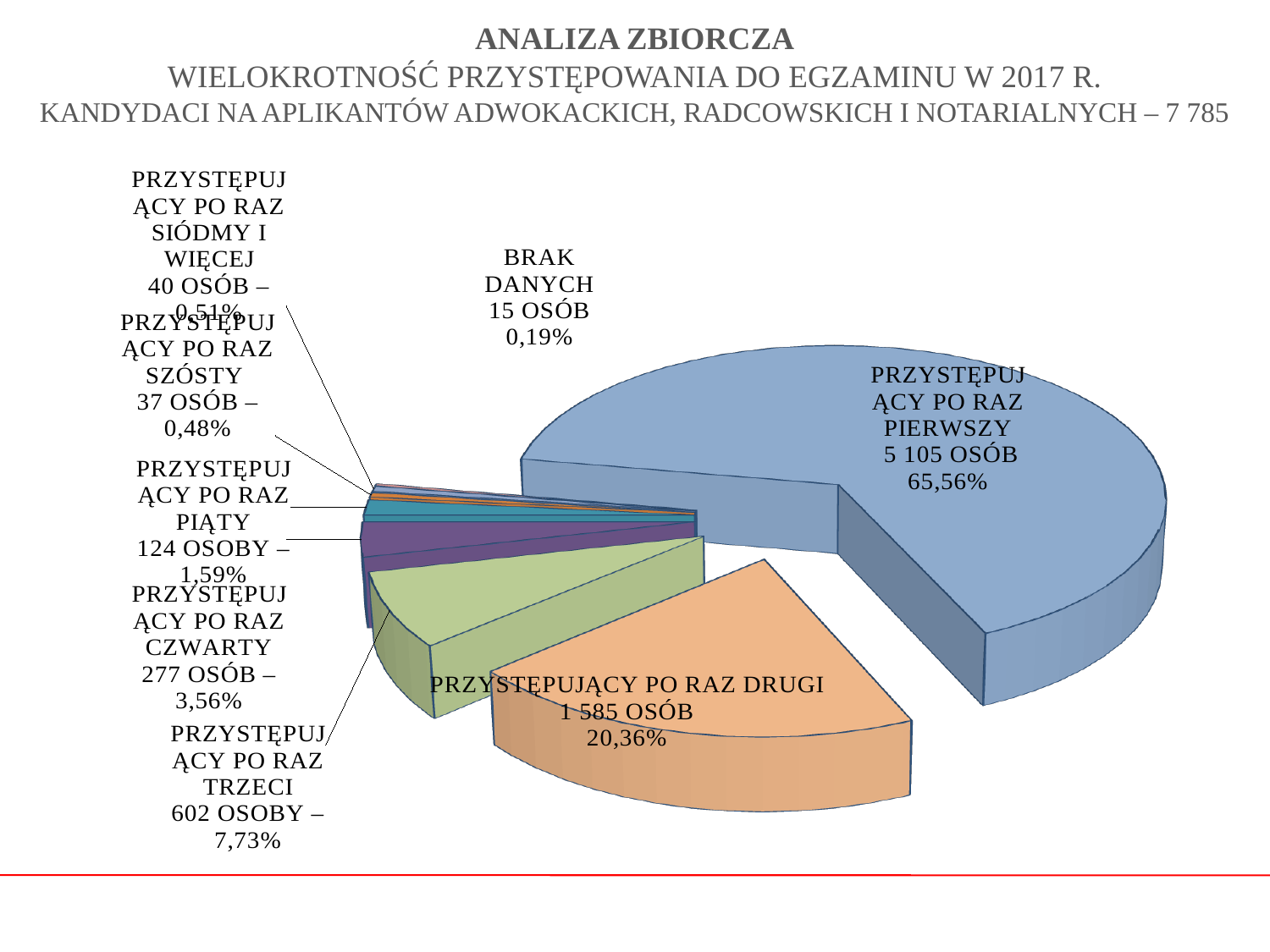
What is the difference in number of people between PRZYSTĘPUJĄCY PO RAZ PIERWSZY and PRZYSTĘPUJĄCY PO RAZ DRUGI? 3 520 Which category has the smallest slice of the pie? BRAK DANYCH What kind of chart is shown on the slide? pie chart Which category has more people: PRZYSTĘPUJĄCY PO RAZ PIĄTY or PRZYSTĘPUJĄCY PO RAZ SZÓSTY? PRZYSTĘPUJĄCY PO RAZ PIĄTY What percentage is shown for PRZYSTĘPUJĄCY PO RAZ CZWARTY? 3,56% How many people are in the BRAK DANYCH category? 15 OSÓB How many people are in the PRZYSTĘPUJĄCY PO RAZ TRZECI category? 602 OSOBY How many people took the exam for the first time (PRZYSTĘPUJĄCY PO RAZ PIERWSZY)? 5 105 OSÓB What total number of candidates is stated in the slide title? 7 785 How many slices does the pie chart have? 8 Which category has the largest slice of the pie? PRZYSTĘPUJĄCY PO RAZ PIERWSZY What percentage share does the PRZYSTĘPUJĄCY PO RAZ DRUGI slice have? 20,36%